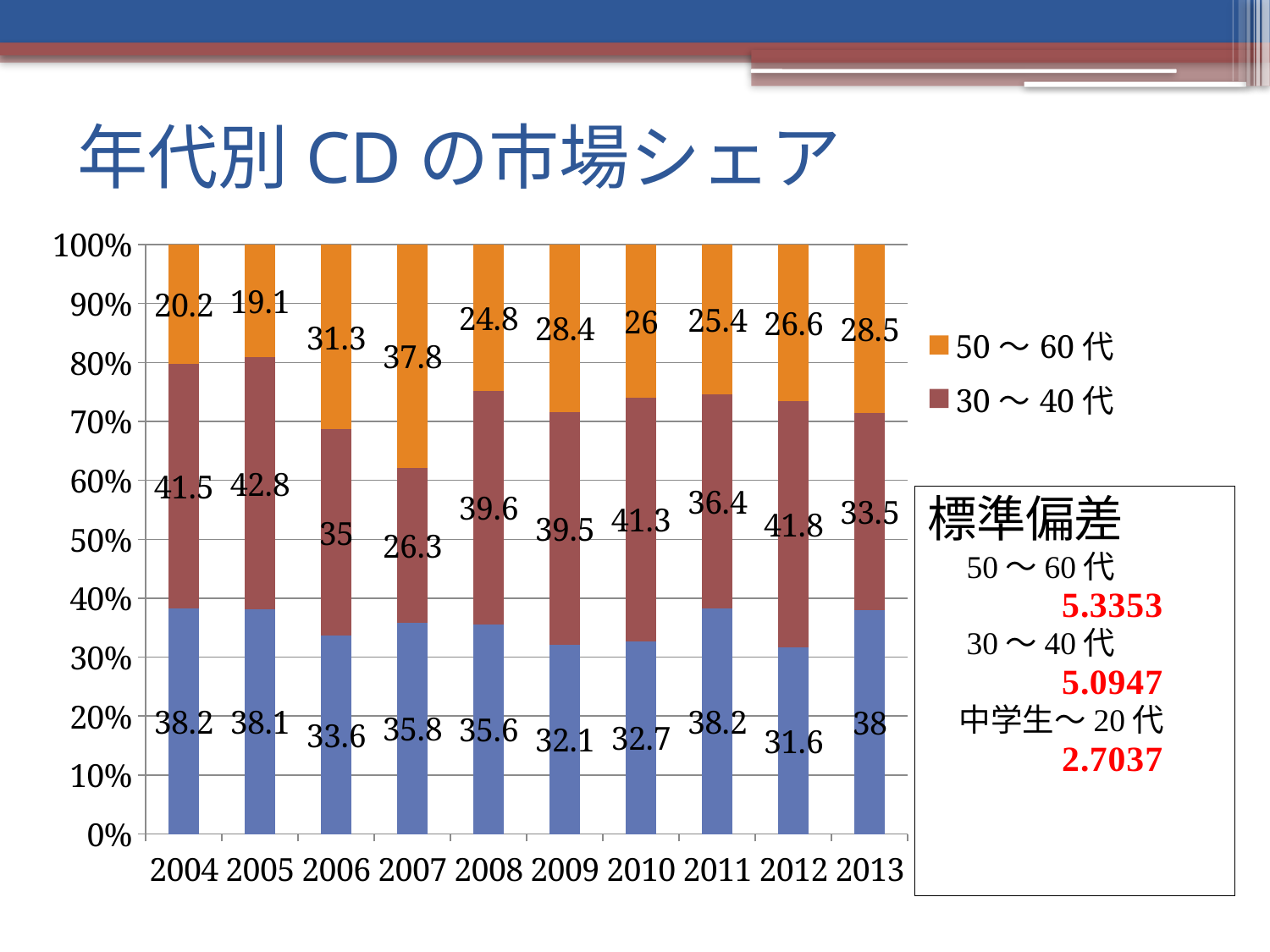
What is the value for 50～60代 in 2007? 37.8 In which year is the 50～60代 value lowest? 2005 How many years are shown on the x axis? 10 In which year is the 30～40代 value lowest? 2007 What is the value of the bottom (blue) segment in 2012? 31.6 What is the value for 50～60代 in 2010? 26 In which year is the 50～60代 value highest? 2007 What is the title of the slide? 年代別 CD の市場シェア What kind of chart is shown on the slide? Stacked bar chart Which is larger in 2006: the 30～40代 value or the 50～60代 value? 30～40代 What is the difference between the 50～60代 values in 2007 and 2004? 17.6 What is the value for 30～40代 in 2005? 42.8